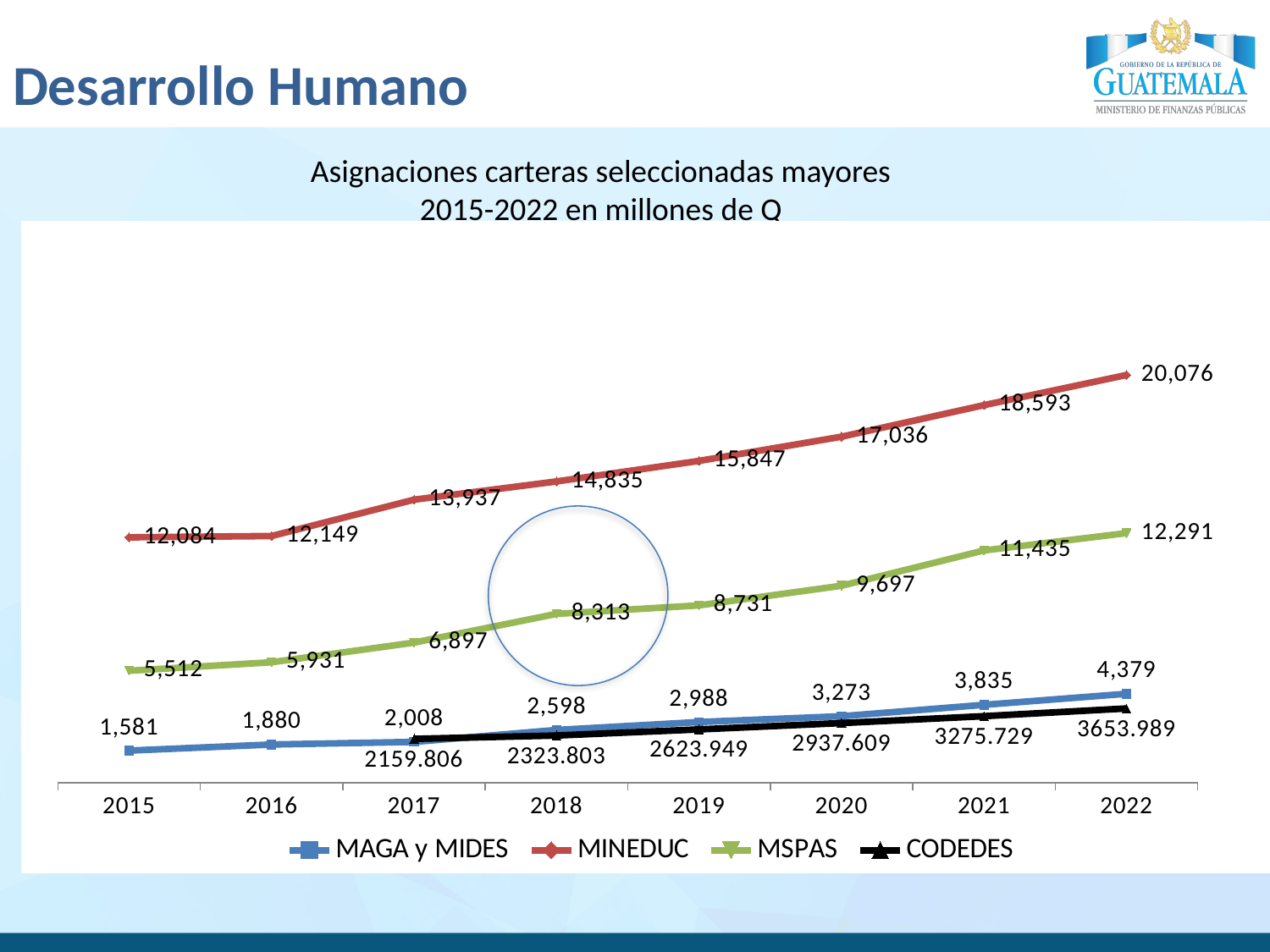
Which series has the lowest value in 2015? MAGA y MIDES How many series does the legend list? 4 What type of chart is shown on the slide? line chart What is the value for MSPAS in 2018? 8,313 What is the value for MINEDUC in 2022? 20,076 Which is larger, the MSPAS value in 2021 or the MINEDUC value in 2015? MINEDUC value in 2015 What is the value for MAGA y MIDES in 2015? 1,581 How many years are shown on the x axis? 8 Does the MSPAS series rise or fall from 2015 to 2022? rise What is the difference between the MINEDUC values for 2022 and 2015? 7,992 Which series has the highest value in 2022? MINEDUC What is the value for CODEDES in 2020? 2937.609